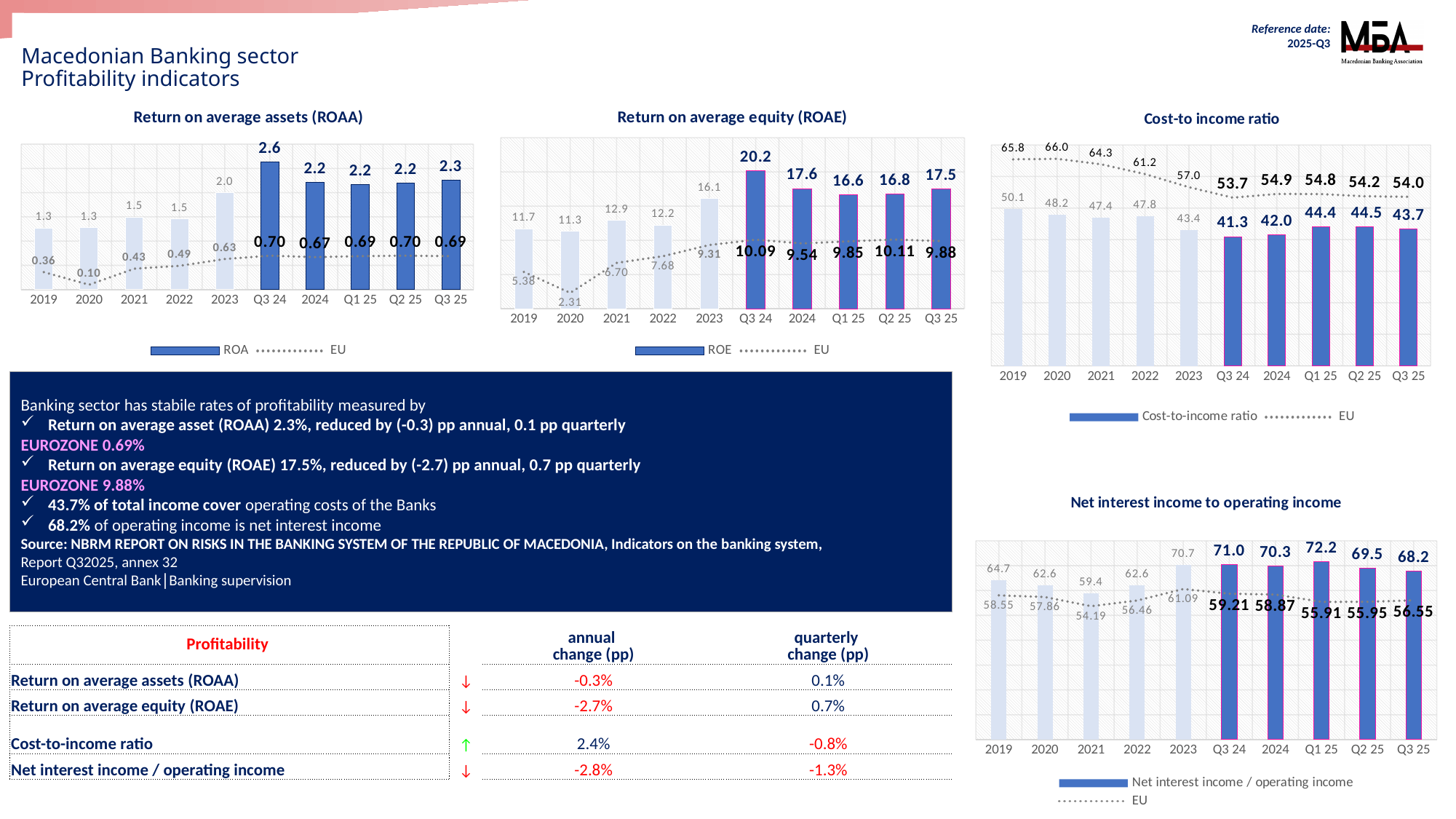
In the Cost-to income ratio chart, what is the Cost-to-income ratio value for Q3 25? 43.7 In the Return on average assets (ROAA) chart, which period has the highest ROA value? Q3 24 How many periods are shown on the x axis of the Cost-to income ratio chart? 10 In the Net interest income to operating income chart, what is the Net interest income / operating income value for Q1 25? 72.2 In the Cost-to income ratio chart, which period has the lowest Cost-to-income ratio value? Q3 24 In the Cost-to income ratio chart, is the EU value for 2019 larger or the Cost-to-income ratio value for 2019? EU In the Net interest income to operating income chart, what is the EU value for 2021? 54.19 In the Return on average equity (ROAE) chart, what is the ROE value for Q3 24? 20.2 In the Return on average equity (ROAE) chart, which period has the lowest EU value? 2020 In the Return on average assets (ROAA) chart, what is the EU value for 2020? 0.10 In the Return on average assets (ROAA) chart, what is the ROA value for Q3 25? 2.3 In the Return on average equity (ROAE) chart, what is the difference between the ROE value for Q3 24 and the ROE value for Q3 25? 2.7